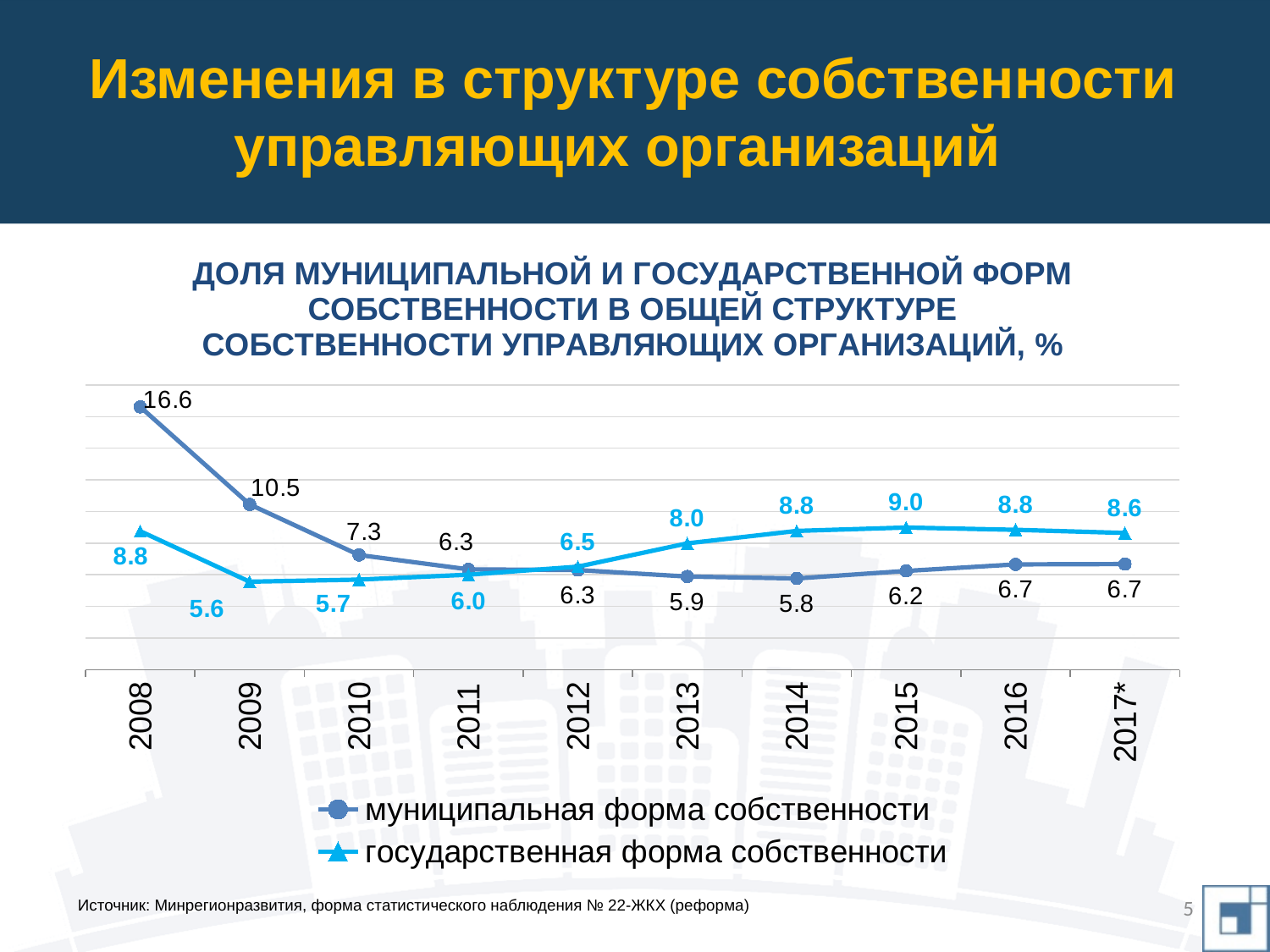
How many series does the legend list? 2 How many years are plotted along the x axis? 10 What is the difference between the государственная and муниципальная values in 2017*? 1.9 What is the value for государственная форма собственности in 2015? 9.0 What is the value for муниципальная форма собственности in 2008? 16.6 What is the difference between the муниципальная форма собственности values in 2008 and 2009? 6.1 In which year is the value for муниципальная форма собственности highest? 2008 In which year is the value for государственная форма собственности lowest? 2009 What type of chart is shown on the slide? line chart What is the value for муниципальная форма собственности in 2014? 5.8 Which series has the larger value in 2013, муниципальная or государственная форма собственности? государственная форма собственности Does the value for муниципальная форма собственности rise or fall from 2008 to 2011? fall